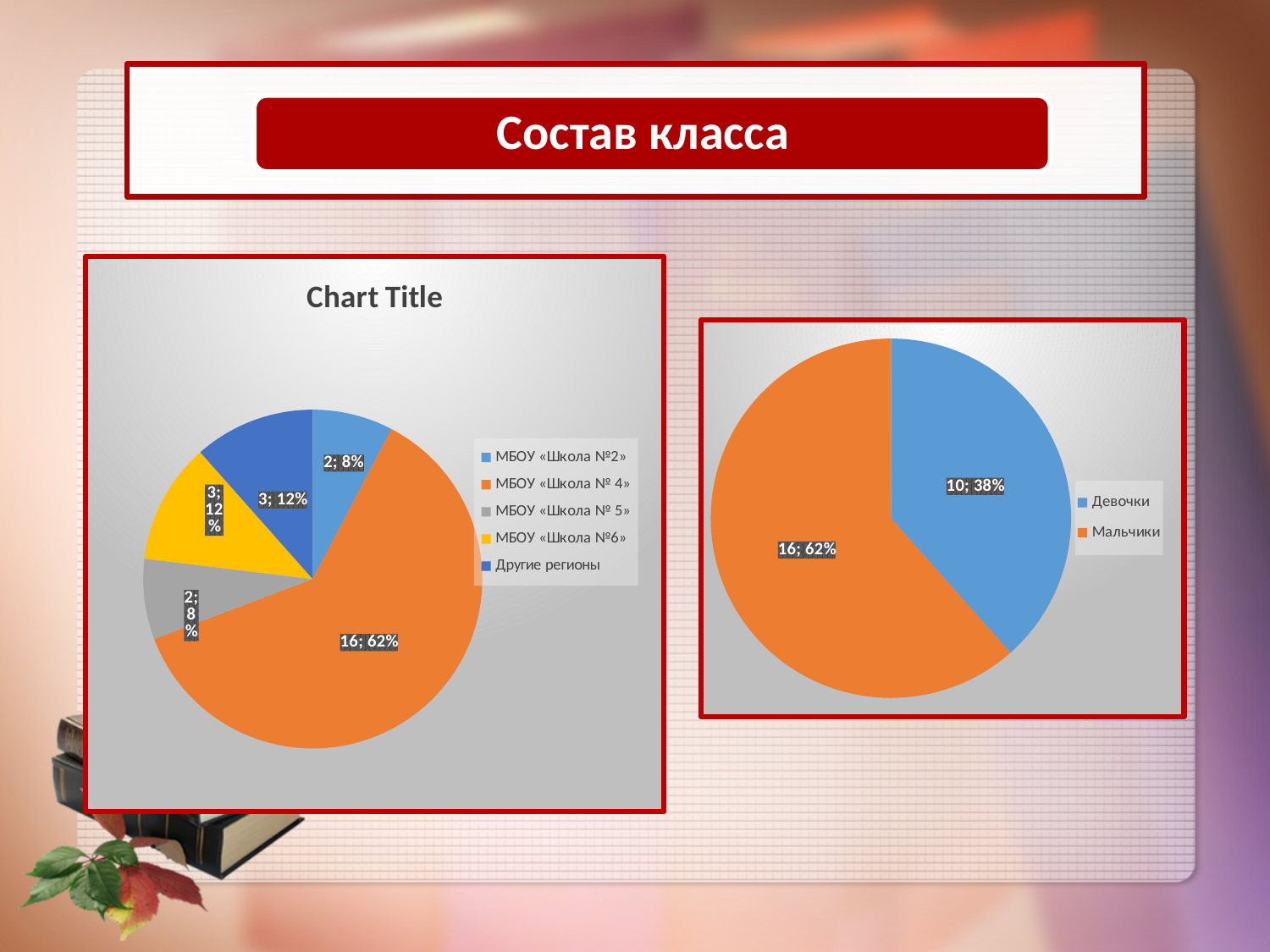
In the right pie chart, which is larger, Девочки or Мальчики? Мальчики In the left chart titled "Chart Title", what is the difference between the values for МБОУ «Школа № 4» and Другие регионы? 13 In the left chart titled "Chart Title", what share of the pie does МБОУ «Школа № 4» have? 62% In the left chart titled "Chart Title", how many students are from МБОУ «Школа № 4»? 16 In the left chart titled "Chart Title", how many categories does the legend list? 5 What kind of chart is the left chart titled "Chart Title"? pie chart In the left chart titled "Chart Title", what colour is the slice for МБОУ «Школа №6»? yellow In the right pie chart, what is the value for Девочки? 10 In the right pie chart, what is the difference between the values for Мальчики and Девочки? 6 In the right pie chart, what share of the pie do Мальчики have? 62% In the left chart titled "Chart Title", which category has the largest slice? МБОУ «Школа № 4» In the left chart titled "Chart Title", what share of the pie does МБОУ «Школа №6» have? 12%